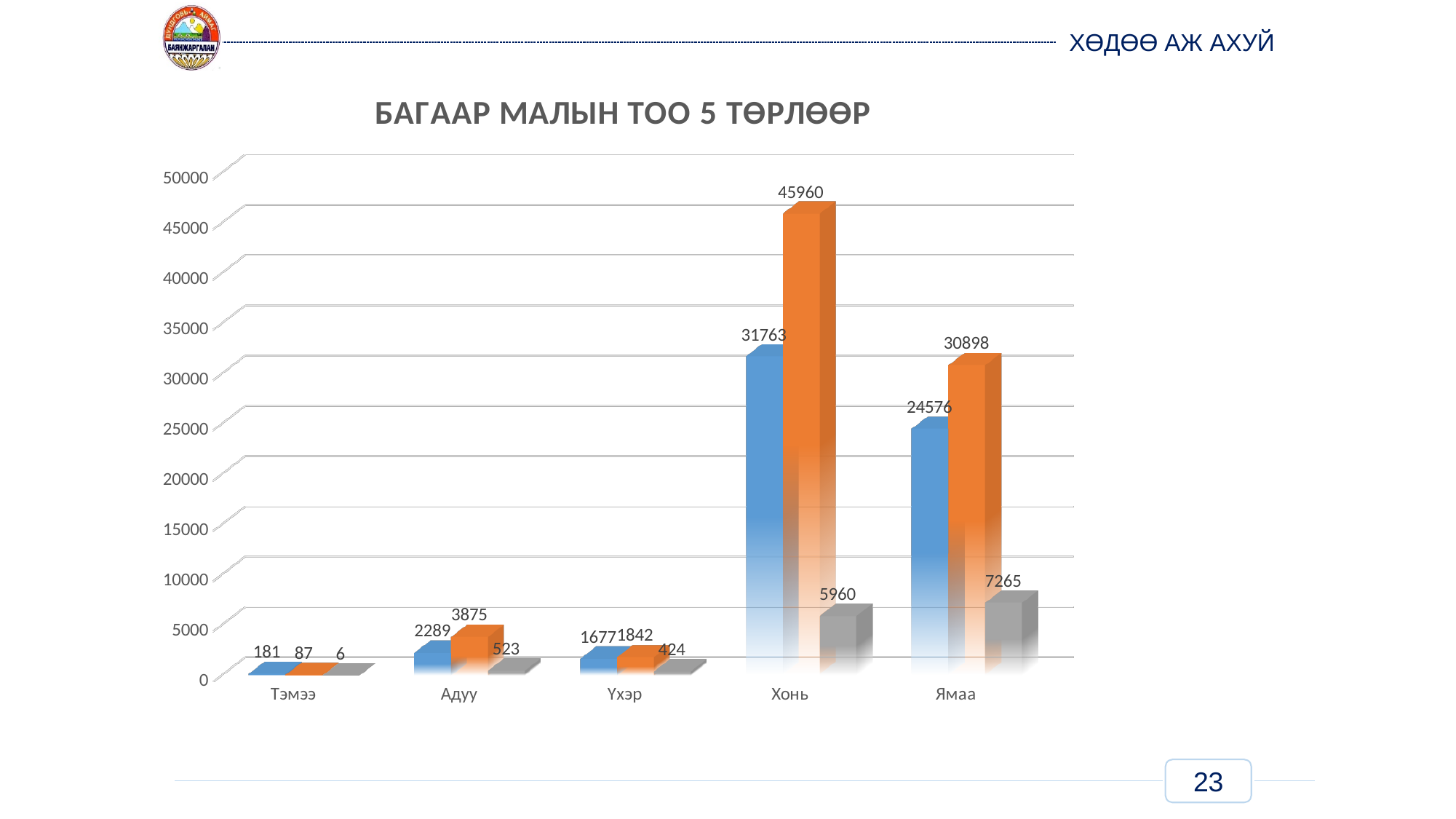
What is the difference between the orange bar and the blue bar for Хонь? 14197 Which is larger for Ямаа, the grey bar or the blue bar? the blue bar What is the title of the chart? БАГААР МАЛЫН ТОО 5 ТӨРЛӨӨР What is the value of the grey bar for Адуу? 523 Is the value of the orange bar for Ямаа greater or less than 25000? greater How many categories are shown on the x axis of the chart? 5 What is the value of the orange bar for Хонь? 45960 What kind of chart is shown on the slide? bar chart What is the value of the blue bar for Үхэр? 1677 Which category has the lowest grey bar? Тэмээ What is the value of the blue bar for Ямаа? 24576 Which category has the highest orange bar? Хонь